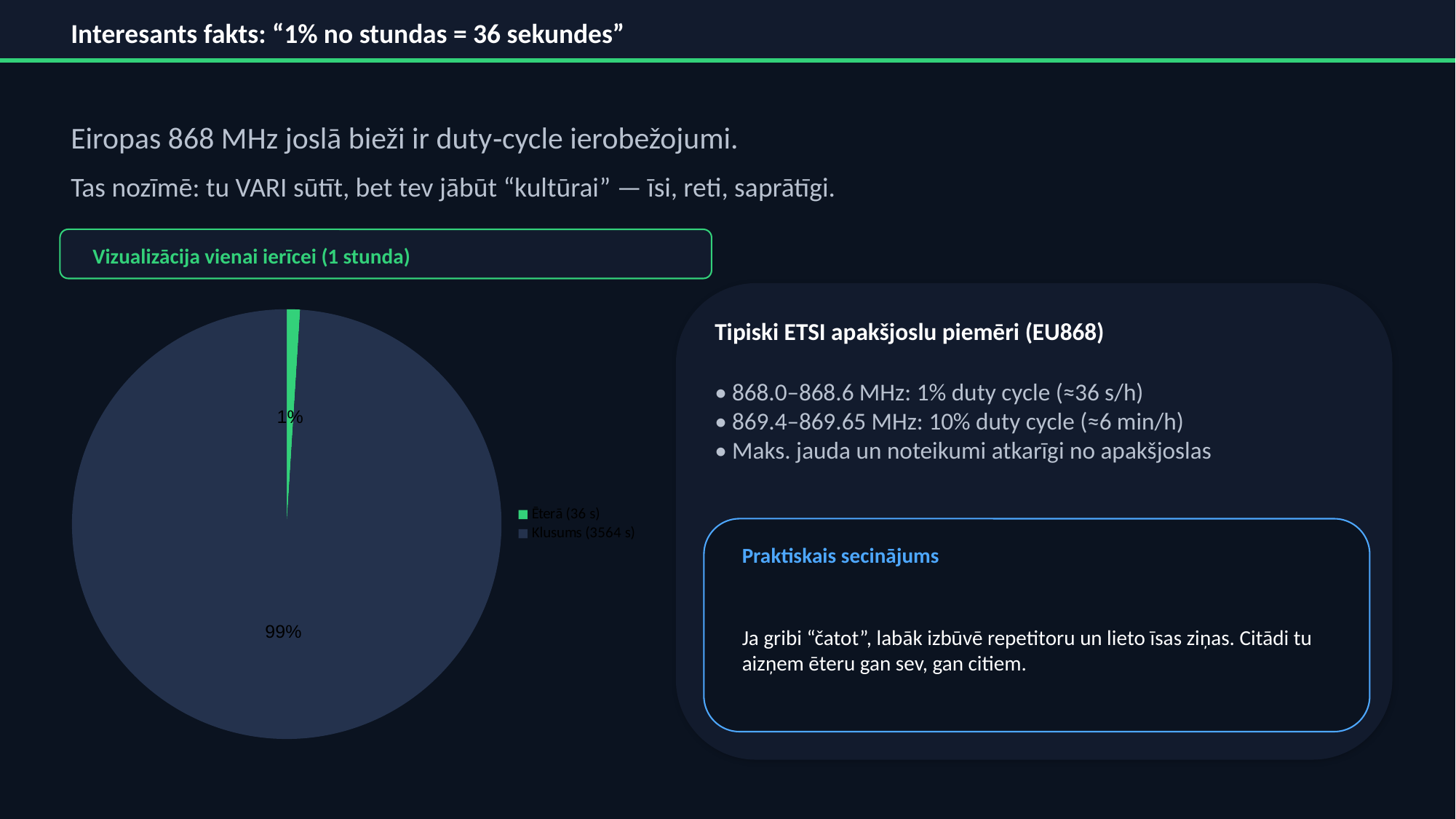
What share of the pie does the "Ēterā (36 s)" slice represent? 1% How many slices does the pie chart have? 2 What is the title of the box above the pie chart? Vizualizācija vienai ierīcei (1 stunda) Which slice of the pie chart is the smallest? Ēterā (36 s) What colour is the "Ēterā (36 s)" slice in the pie chart? green How many entries does the pie chart's legend list? 2 Which slice of the pie chart is the largest? Klusums (3564 s) What is the difference in percentage points between the "Klusums (3564 s)" slice and the "Ēterā (36 s)" slice? 98 percentage points What share of the pie does the "Klusums (3564 s)" slice represent? 99% What kind of chart is shown on the slide? pie chart Which is larger in the pie chart: the "Ēterā (36 s)" slice or the "Klusums (3564 s)" slice? Klusums (3564 s)